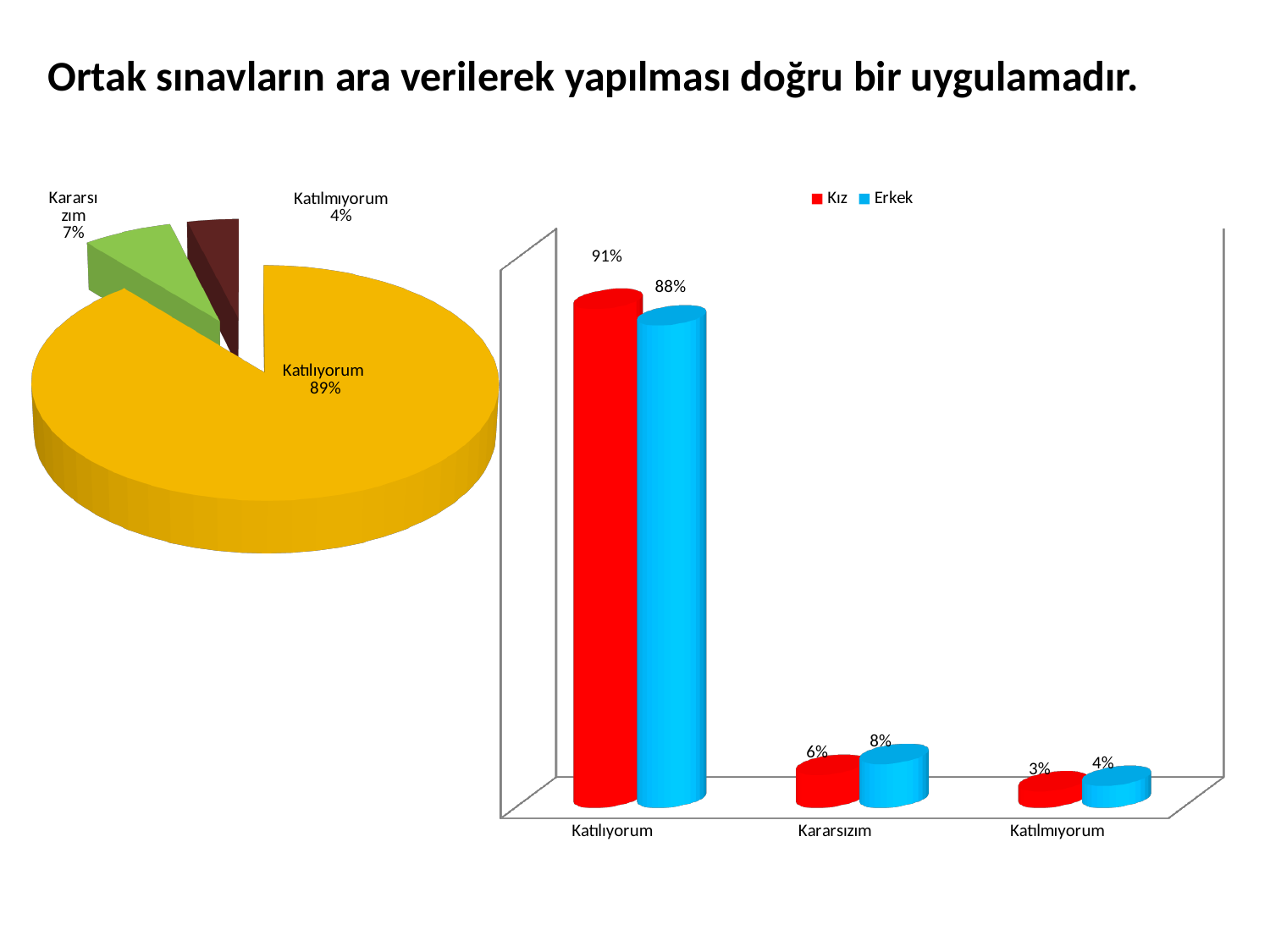
In the bar chart on the right, what is the value for Erkek in the Kararsızım category? 8% In the pie chart on the left, what share does Katılıyorum have? 89% In the pie chart on the left, what share does Kararsızım have? 7% In the bar chart on the right, what is the value for Kız in the Katılmıyorum category? 3% In the bar chart on the right, which is larger in the Kararsızım category, Kız or Erkek? Erkek In the pie chart on the left, which category has the smallest slice? Katılmıyorum How many slices does the pie chart on the left have? 3 What kind of chart is the chart on the right of the slide? Bar chart How many series does the legend of the bar chart on the right list? 2 In the bar chart on the right, which category has the highest value for Erkek? Katılıyorum In the bar chart on the right, what is the value for Kız in the Katılıyorum category? 91% In the bar chart on the right, what is the difference between Kız and Erkek in the Katılıyorum category? 3%